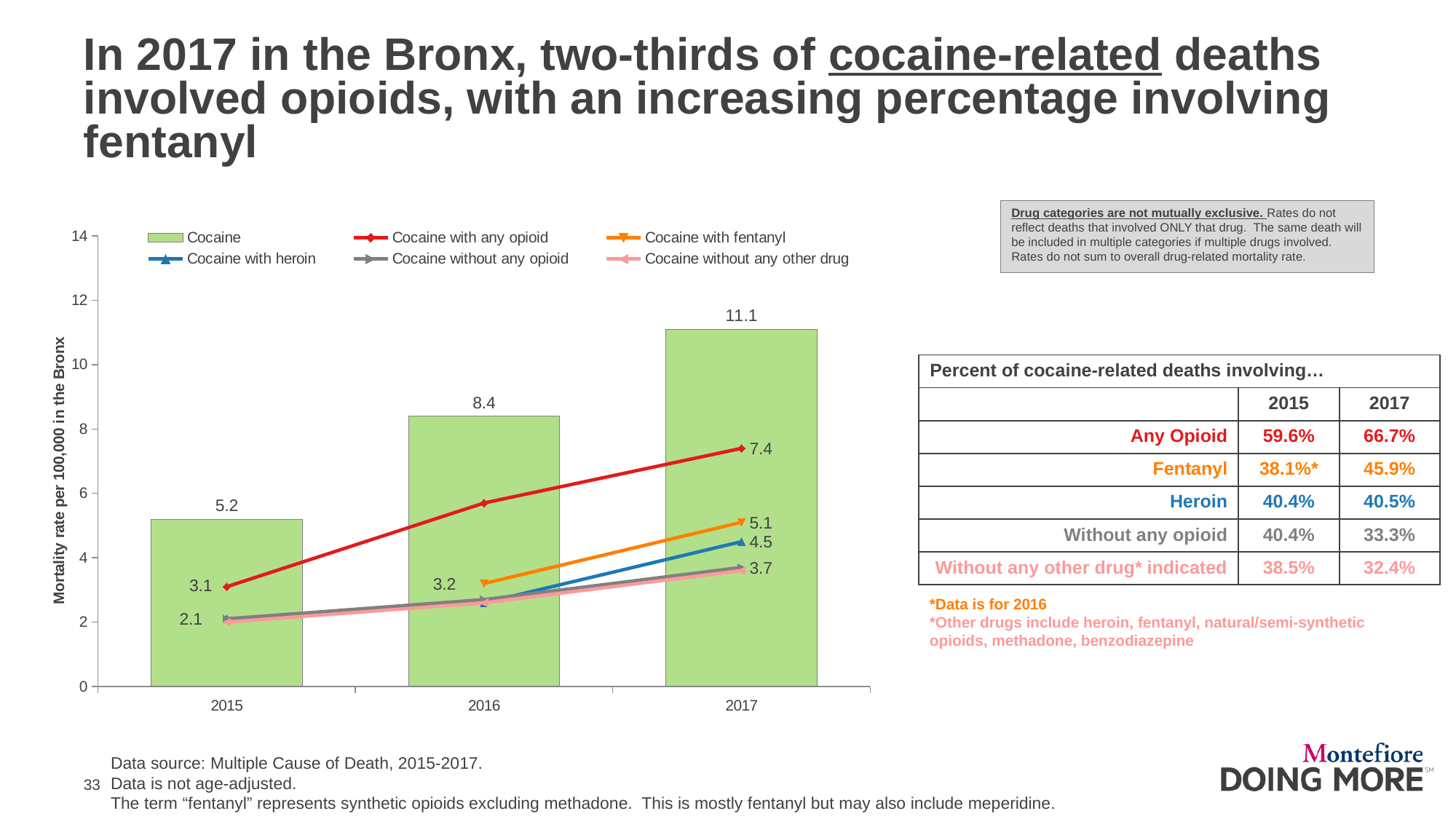
What is the value for Cocaine with fentanyl in 2017? 5.1 How many series does the chart legend list? 6 How many years are shown on the x axis of the chart? 3 What is the value of the Cocaine bar for 2015? 5.2 In 2017, which is larger: Cocaine with fentanyl or Cocaine with heroin? Cocaine with fentanyl By how much did the Cocaine bar value increase from 2015 to 2017? 5.9 Is the value for Cocaine with any opioid in 2016 greater or less than 6? less What is the value for Cocaine with heroin in 2017? 4.5 What is the cocaine-related mortality rate per 100,000 in the Bronx in 2017? 11.1 Which year has the highest Cocaine bar? 2017 What is the value for Cocaine with any opioid in 2017? 7.4 Do the Cocaine bar values rise or fall from 2015 to 2017? rise